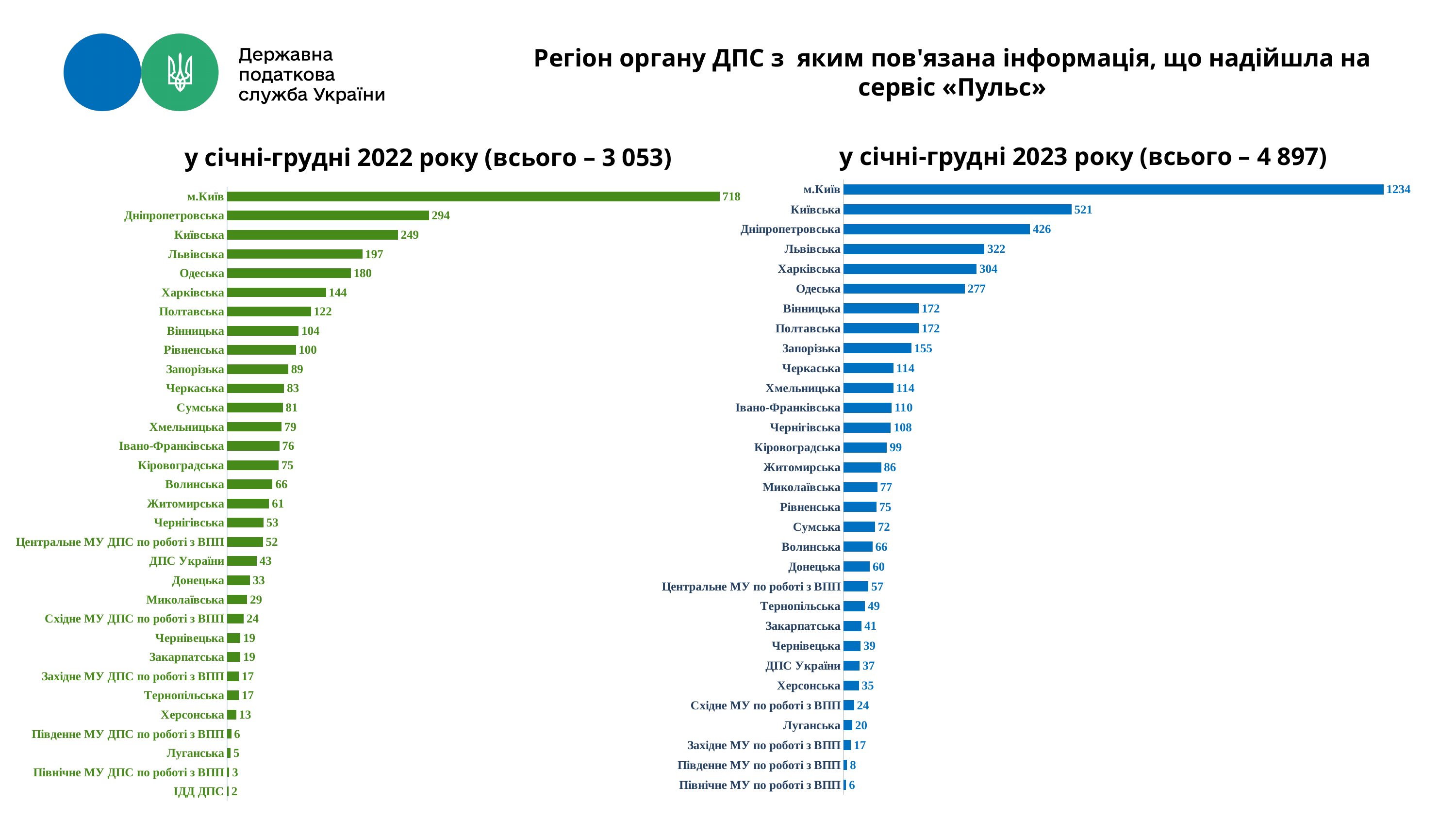
How many categories are shown in the 2023 chart (right)? 31 In the 2022 chart (left), what is the value for Полтавська? 122 In the 2023 chart (right), which category has the highest value? м.Київ In the 2022 chart (left), what is the difference between the values for м.Київ and Дніпропетровська? 424 In the 2023 chart (right), what is the difference between the values for Київська and Дніпропетровська? 95 In the 2022 chart (left), which is larger: the value for Одеська or the value for Харківська? Одеська In the 2023 chart (right), what is the value for Північне МУ по роботі з ВПП? 6 What total is stated in the title of the 2023 chart (right)? 4 897 In the 2022 chart (left), which category has the lowest value? ІДД ДПС What type of chart is the 2022 chart (left)? Bar chart In the 2023 chart (right), what is the value for Львівська? 322 In the 2022 chart (left), what is the value for м.Київ? 718